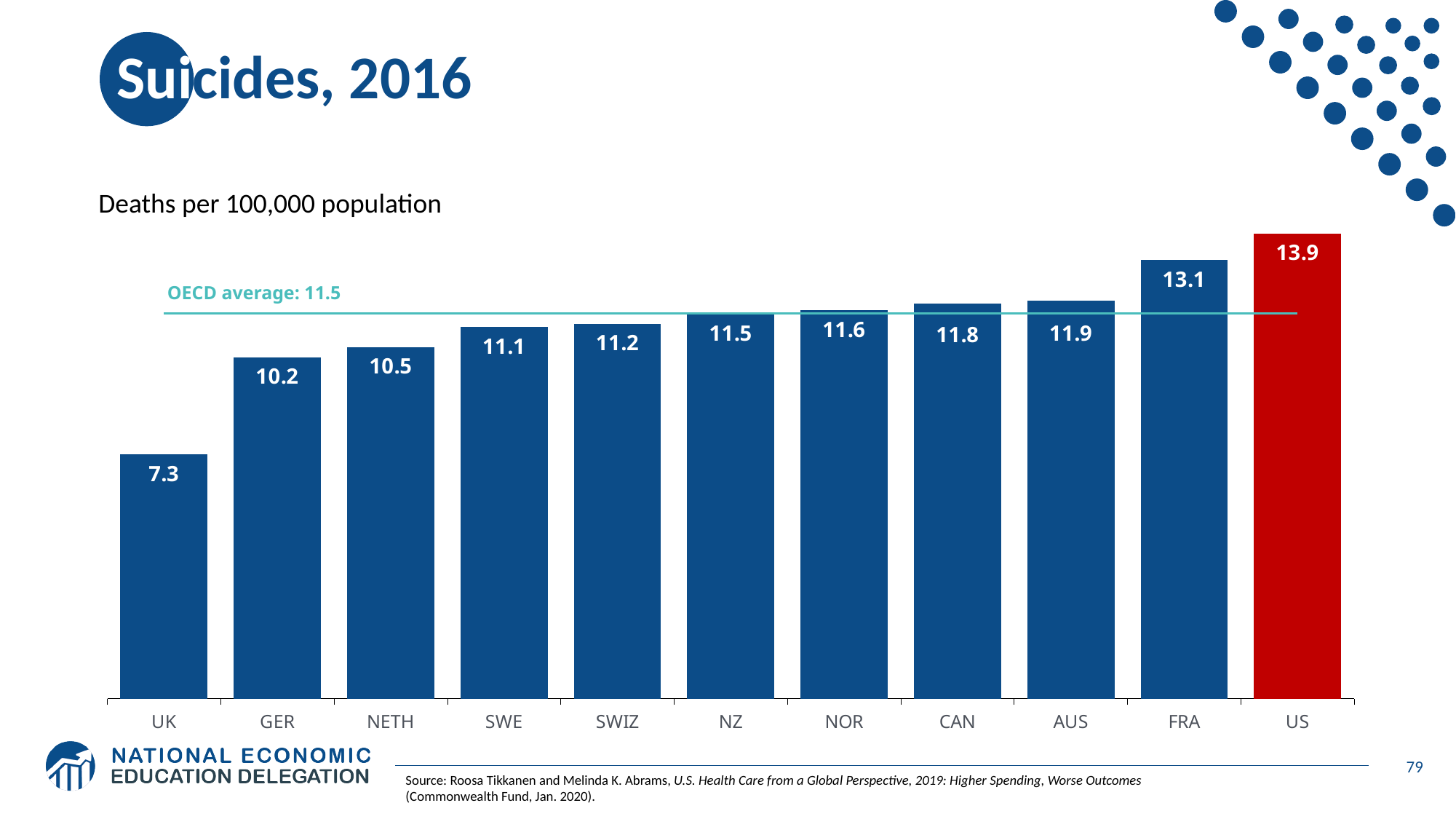
What is the difference between the US value and the France (FRA) value? 0.8 Which country has the lowest suicide rate on the chart? UK Which country's bar is coloured red? US What is the value shown for Canada (CAN)? 11.8 Which country has the highest suicide rate on the chart? US What is the value shown for Germany (GER)? 10.2 Which has a higher value, Sweden (SWE) or Switzerland (SWIZ)? SWIZ What is the suicide rate (deaths per 100,000 population) for the UK? 7.3 How many countries are shown on the chart? 11 What is the OECD average shown on the chart? 11.5 What is the difference between the US value and the UK value? 6.6 What kind of chart is shown on the slide? Bar chart